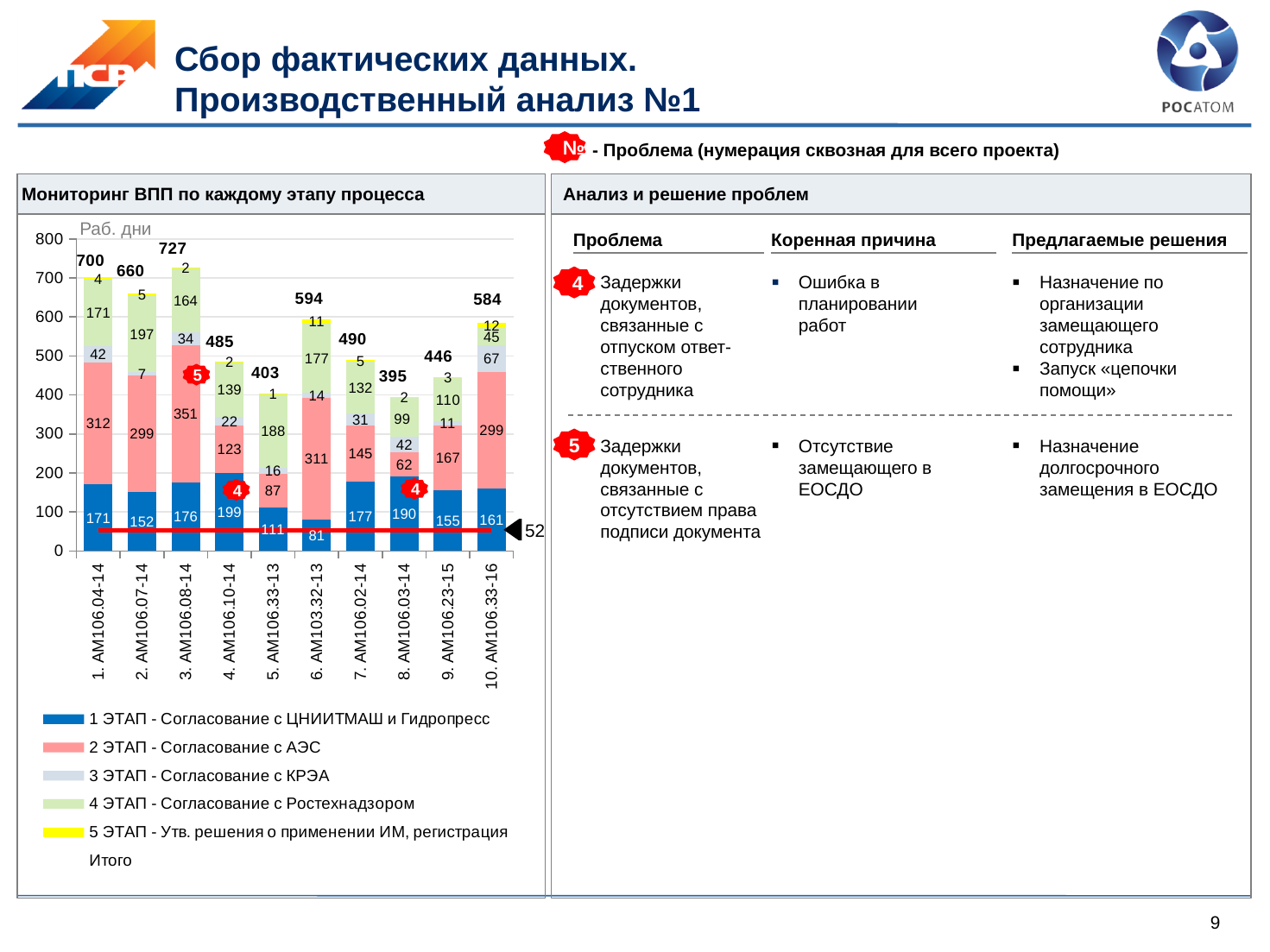
Which has a larger total value: 7. АМ106.02-14 or 9. АМ106.23-15? 7. АМ106.02-14 What is the value of '1 ЭТАП - Согласование с ЦНИИТМАШ и Гидропресс' for category 4. АМ106.10-14? 199 What is the value of '4 ЭТАП - Согласование с Ростехнадзором' for category 5. АМ106.33-13? 188 Which category has the lowest total value in the chart? 8. АМ106.03-14 How many categories (bars) are shown on the x axis of the chart? 10 What is the difference between the total values of 1. АМ106.04-14 and 2. АМ106.07-14? 40 What is the axis label shown above the y axis of the chart? Раб. дни How many entries does the chart legend list? 6 Which category has the highest total value in the chart? 3. АМ106.08-14 What is the value of '2 ЭТАП - Согласование с АЭС' for category 3. АМ106.08-14? 351 What type of chart is shown on the slide? stacked bar chart What is the total value for category 6. АМ103.32-13? 594